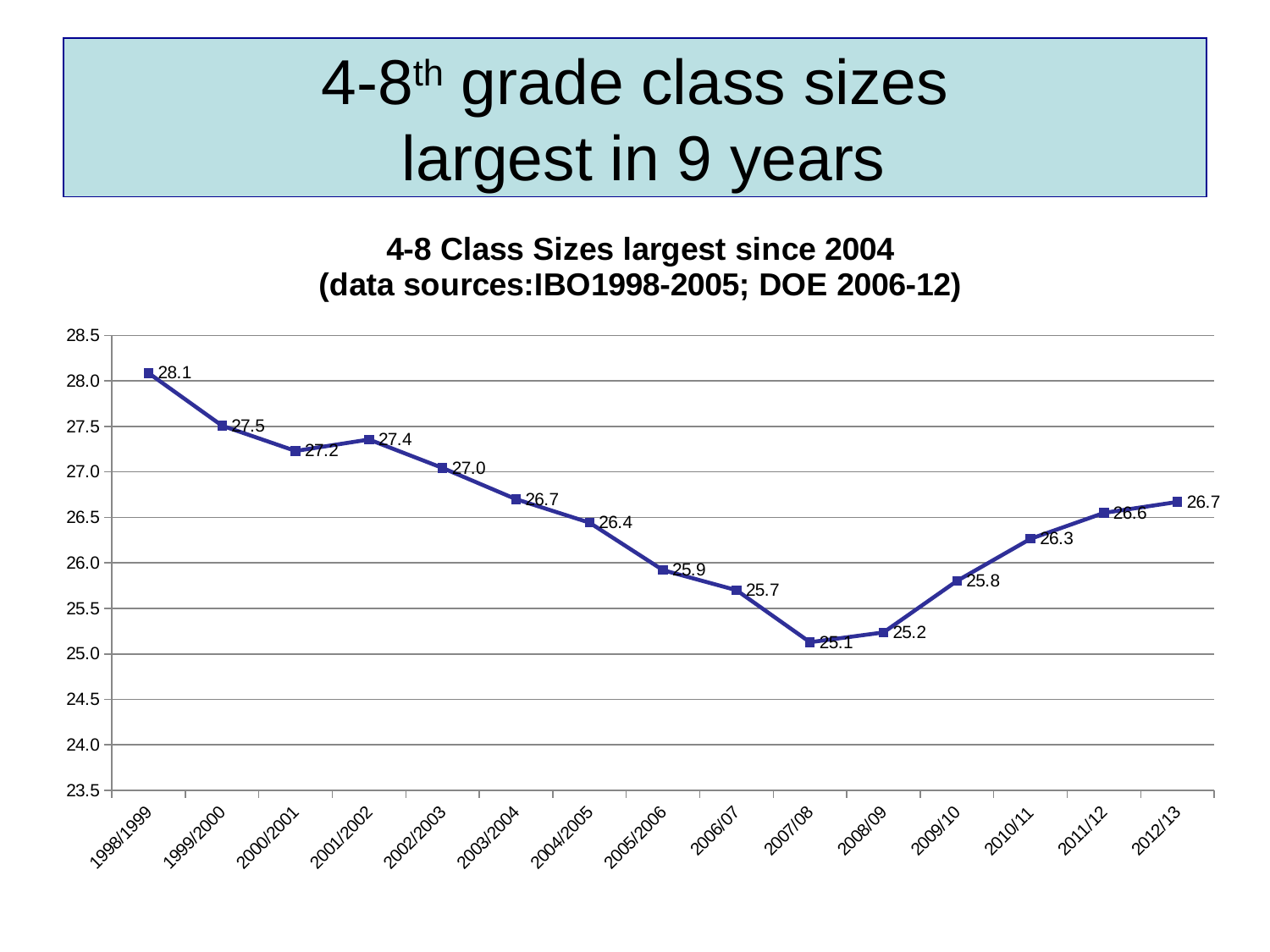
Which year has the highest class size? 1998/1999 What is the title of the chart? 4-8 Class Sizes largest since 2004 (data sources:IBO1998-2005; DOE 2006-12) How many school years are plotted on the chart? 15 Which year has the lowest class size? 2007/08 What is the class size value for 2012/13? 26.7 Which is larger, the class size in 2001/2002 or in 2000/2001? 2001/2002 Is the value for 2009/10 greater or less than 26.0? less Do the class sizes rise or fall from 1998/1999 to 2007/08? fall What is the class size value for 1998/1999? 28.1 What is the difference between the class size in 1998/1999 and in 2007/08? 3.0 What is the class size value for 2007/08? 25.1 What kind of chart is shown on the slide? line chart